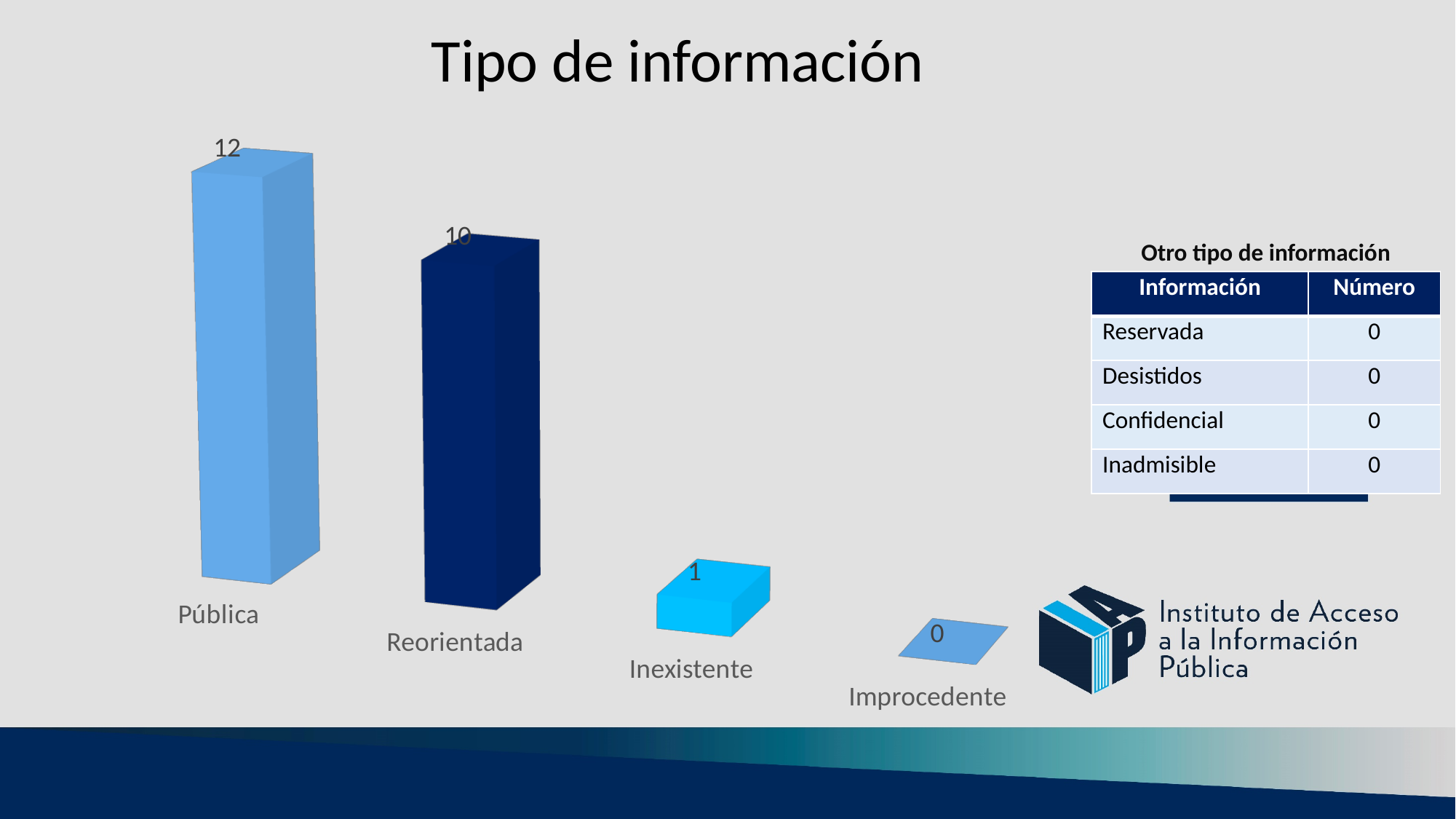
What is the value for Inexistente? 1 Which is larger, the value for Reorientada or the value for Inexistente? Reorientada What is the value for Improcedente? 0 Do the values rise or fall from left to right across the categories? Fall How many categories are shown in the chart? 4 What is the difference between the values for Pública and Reorientada? 2 What kind of chart is shown on the slide? Bar chart What is the value for Pública? 12 What is the value for Reorientada? 10 What is the title of the chart? Tipo de información Which category has the lowest value? Improcedente Which category has the highest value? Pública